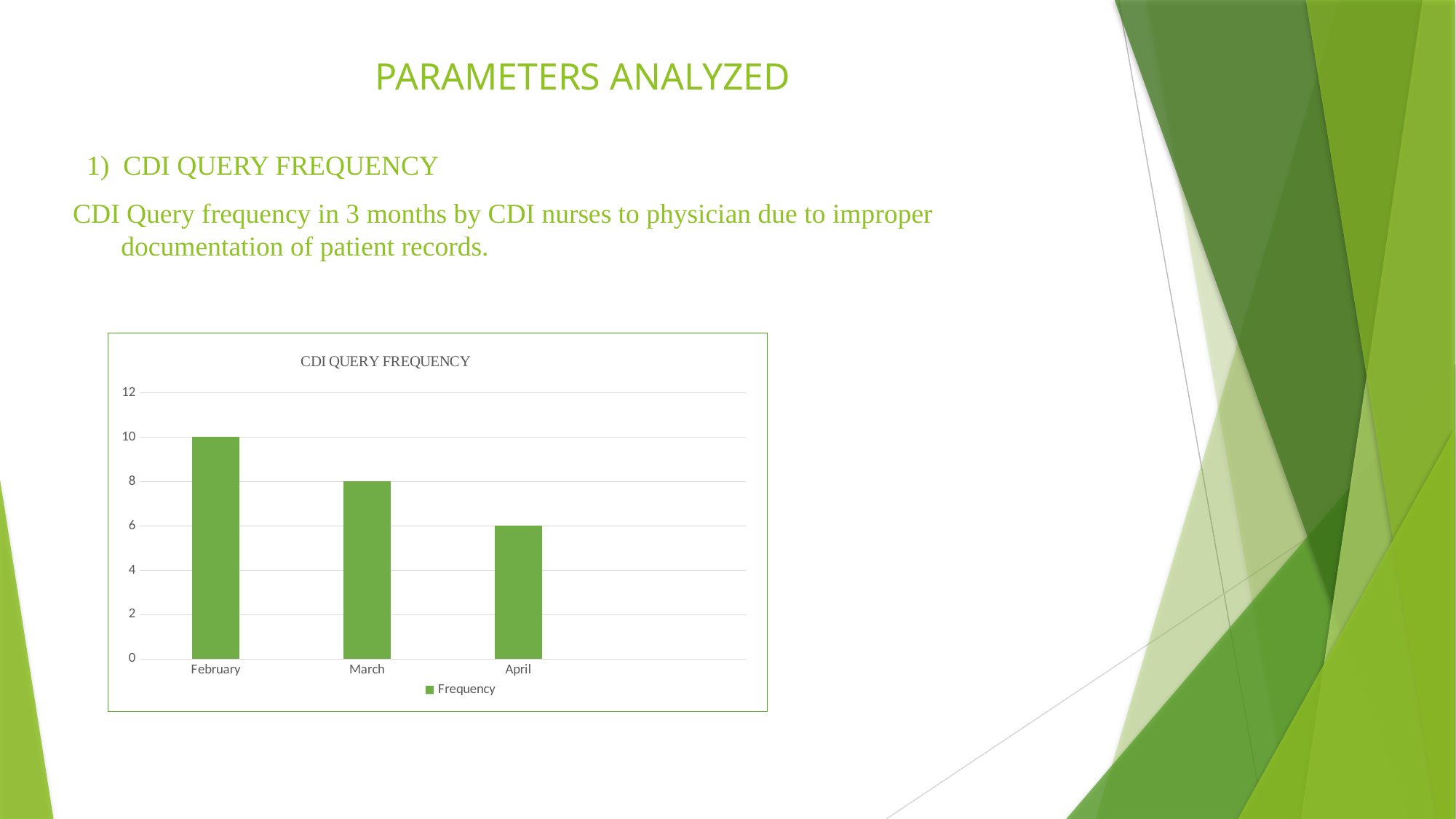
What is the CDI query frequency for March? 8 What is the title of the chart? CDI QUERY FREQUENCY How many series does the chart legend list? 1 What is the name of the series shown in the chart legend? Frequency How many months are shown on the x axis of the chart? 3 Do the CDI query frequency values rise or fall from February to April? fall What is the CDI query frequency for April? 6 Which month has the highest CDI query frequency? February What is the CDI query frequency for February? 10 Which month has the lowest CDI query frequency? April What is the difference between the CDI query frequency in February and in April? 4 What type of chart is shown on the slide? bar chart